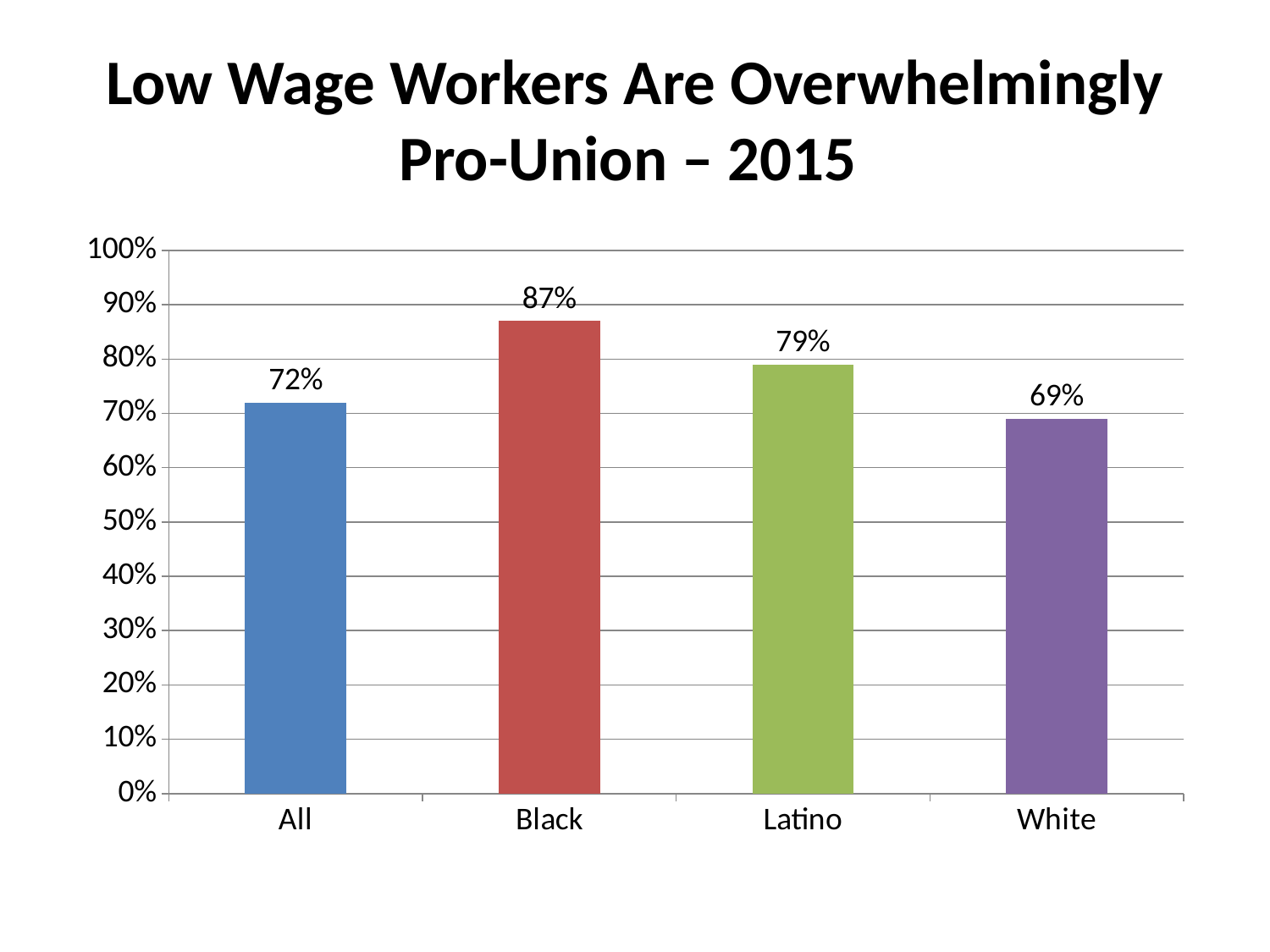
What kind of chart is shown on the slide? bar chart What is the value for Latino? 79% How many categories are shown on the x axis? 4 What is the value for White? 69% Which category has the lowest value? White Is the value for White greater or less than 60%? greater What is the value for Black? 87% What is the difference between the values for Latino and All? 7% What is the value for All? 72% Which category has the highest value? Black What is the difference between the values for Black and White? 18% Which is larger, the value for Latino or the value for All? Latino